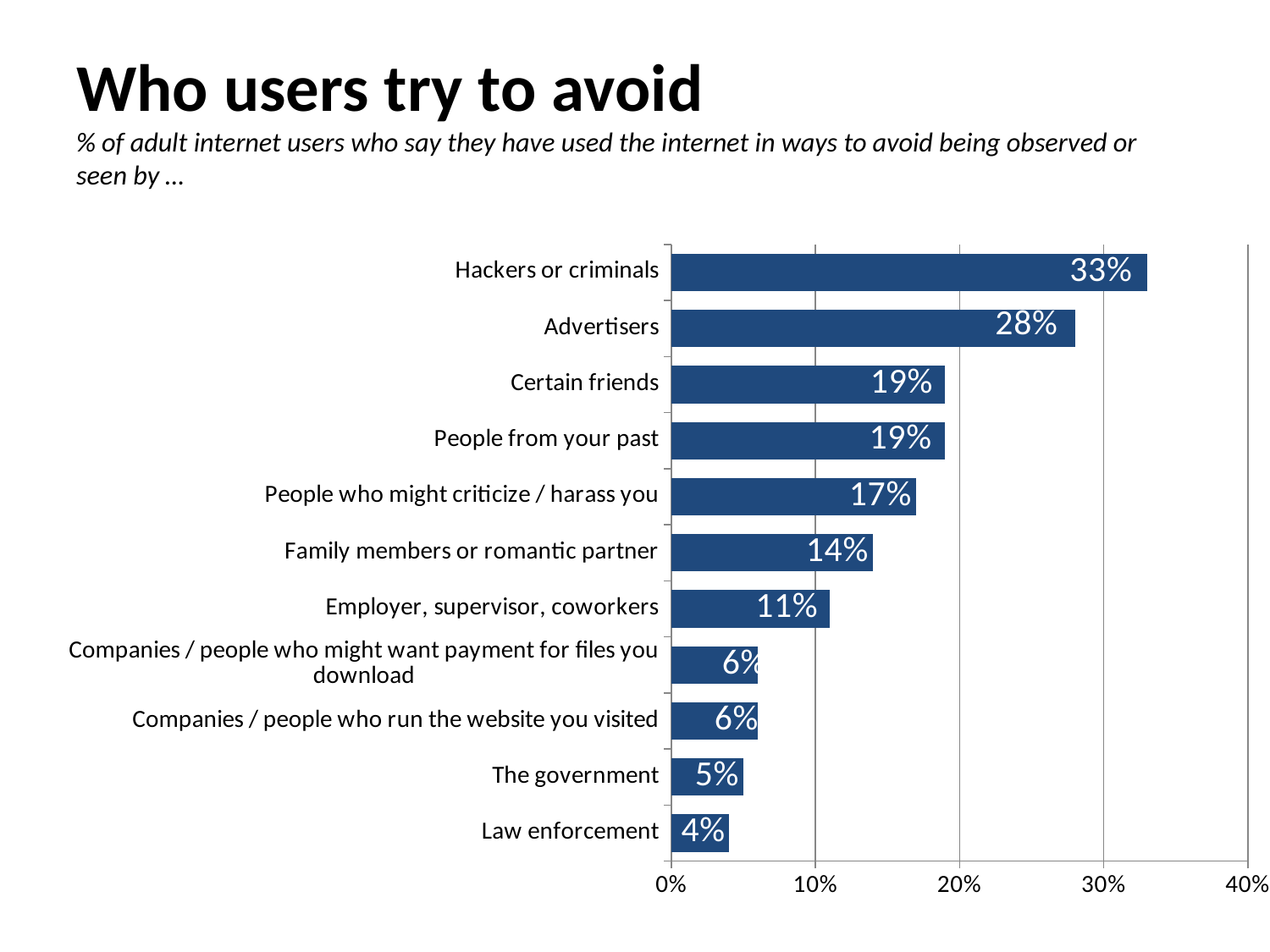
What is the value for The government? 5% Which category has the lowest value? Law enforcement Which category has the highest value? Hackers or criminals What is the value for Advertisers? 28% What is the difference between the values for Hackers or criminals and Advertisers? 5% Is the value for People who might criticize / harass you greater or less than 20%? less What kind of chart is shown on the slide? Bar chart What is the title of the slide? Who users try to avoid Which is larger, the value for Employer, supervisor, coworkers or the value for Family members or romantic partner? Family members or romantic partner What percentage of adult internet users say they have used the internet in ways to avoid being observed by hackers or criminals? 33% How many categories are shown in the chart? 11 What is the value for Family members or romantic partner? 14%